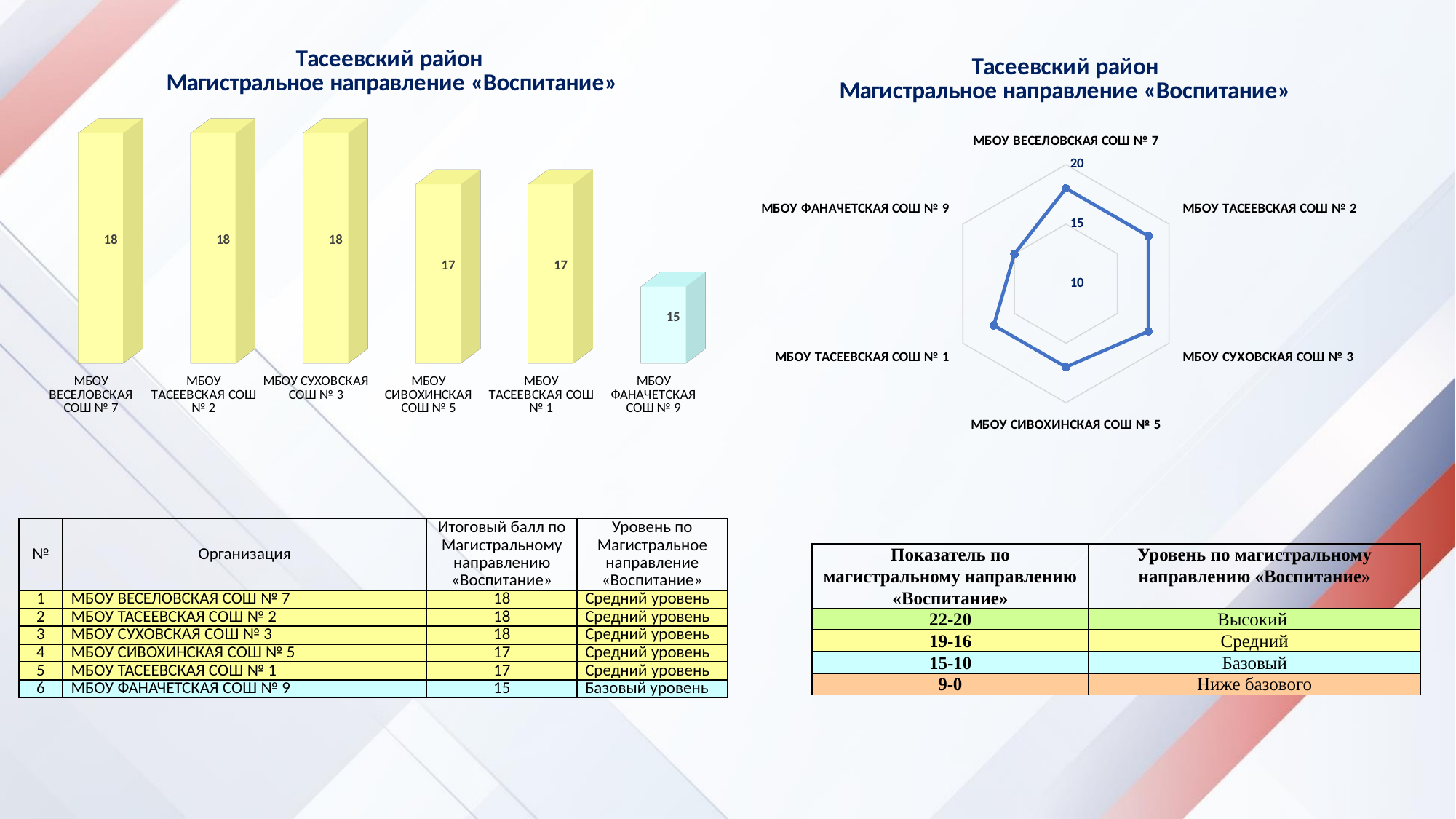
In the radar chart on the right, is the value for МБОУ ВЕСЕЛОВСКАЯ СОШ № 7 greater or less than 15? greater In the bar chart on the left, which bar is shown in a different colour from the others? МБОУ ФАНАЧЕТСКАЯ СОШ № 9 In the bar chart on the left, which is larger: the value for МБОУ ТАСЕЕВСКАЯ СОШ № 2 or the value for МБОУ ТАСЕЕВСКАЯ СОШ № 1? МБОУ ТАСЕЕВСКАЯ СОШ № 2 What kind of chart is the chart on the right of the slide? radar chart In the bar chart on the left, what is the difference between the values for МБОУ ВЕСЕЛОВСКАЯ СОШ № 7 and МБОУ ФАНАЧЕТСКАЯ СОШ № 9? 3 What kind of chart is the chart on the left of the slide? bar chart In the radar chart on the right, is the value for МБОУ СУХОВСКАЯ СОШ № 3 greater or less than 20? less In the bar chart on the left, what is the value for МБОУ СИВОХИНСКАЯ СОШ № 5? 17 In the bar chart on the left, what is the value for МБОУ СУХОВСКАЯ СОШ № 3? 18 In the bar chart on the left, which category has the lowest value? МБОУ ФАНАЧЕТСКАЯ СОШ № 9 How many categories are shown in the bar chart on the left? 6 In the bar chart on the left, what is the value for МБОУ ФАНАЧЕТСКАЯ СОШ № 9? 15